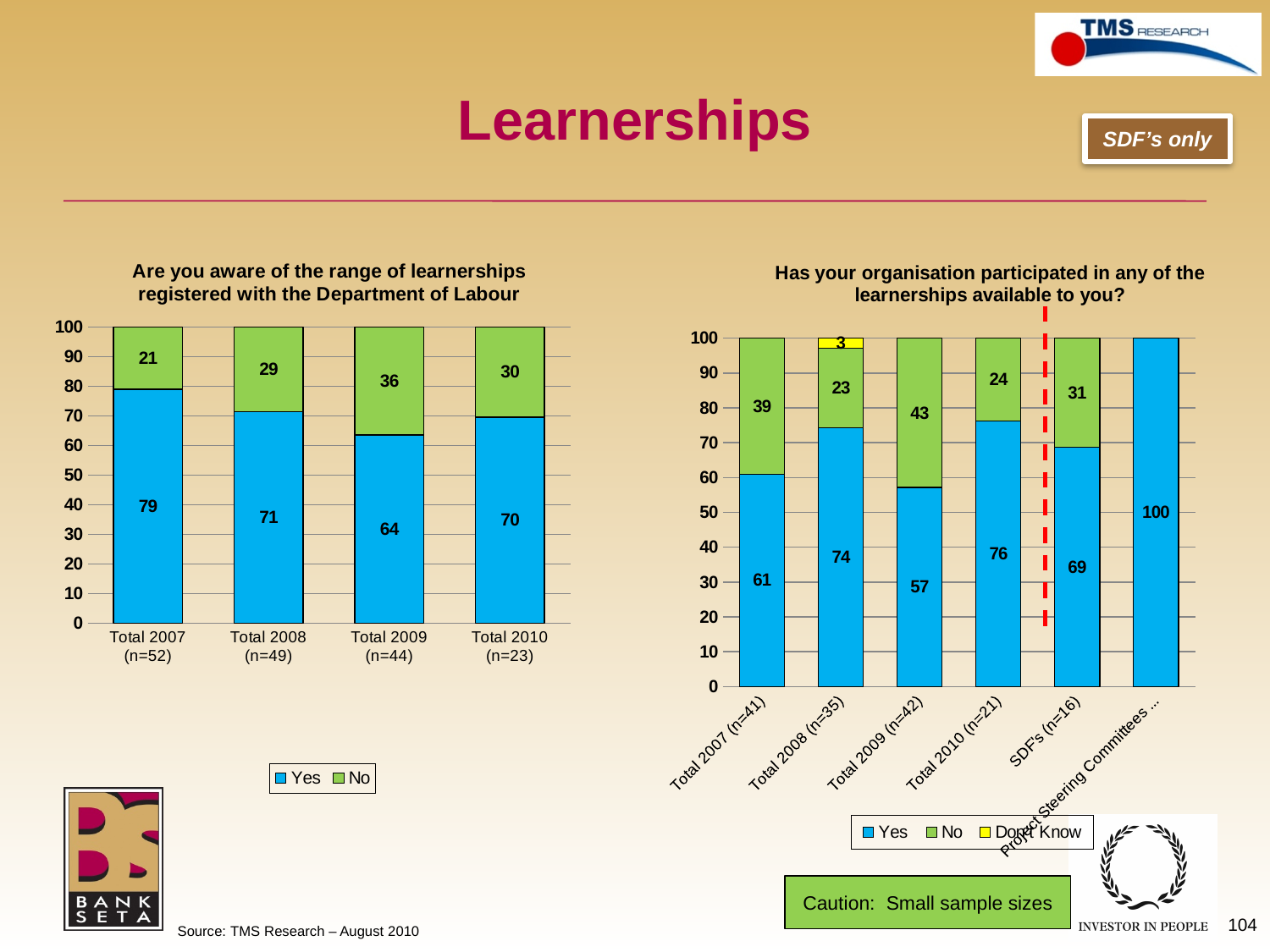
In the right chart (participation in learnerships), is the Yes value for Total 2010 (n=21) larger or smaller than the Yes value for SDF's (n=16)? larger In the right chart (participation in learnerships), what is the Don't Know value for Total 2008 (n=35)? 3 In the right chart (participation in learnerships), what is the Yes value for Total 2009 (n=42)? 57 In the left chart (awareness of learnerships), what is the No value for Total 2009 (n=44)? 36 In the right chart (participation in learnerships), how many categories are shown on the x axis? 6 In the right chart (participation in learnerships), which category has the highest Yes value? Project Steering Committees In the left chart (awareness of learnerships), how many series does the legend list? 2 What type of chart is the right chart (participation in learnerships)? Stacked bar chart In the left chart (awareness of learnerships), which category has the highest Yes value? Total 2007 (n=52) In the left chart (awareness of learnerships), what is the Yes value for Total 2007 (n=52)? 79 In the left chart (awareness of learnerships), what is the difference between the Yes values for Total 2007 and Total 2008? 8 In the left chart (awareness of learnerships), which category has the lowest Yes value? Total 2009 (n=44)